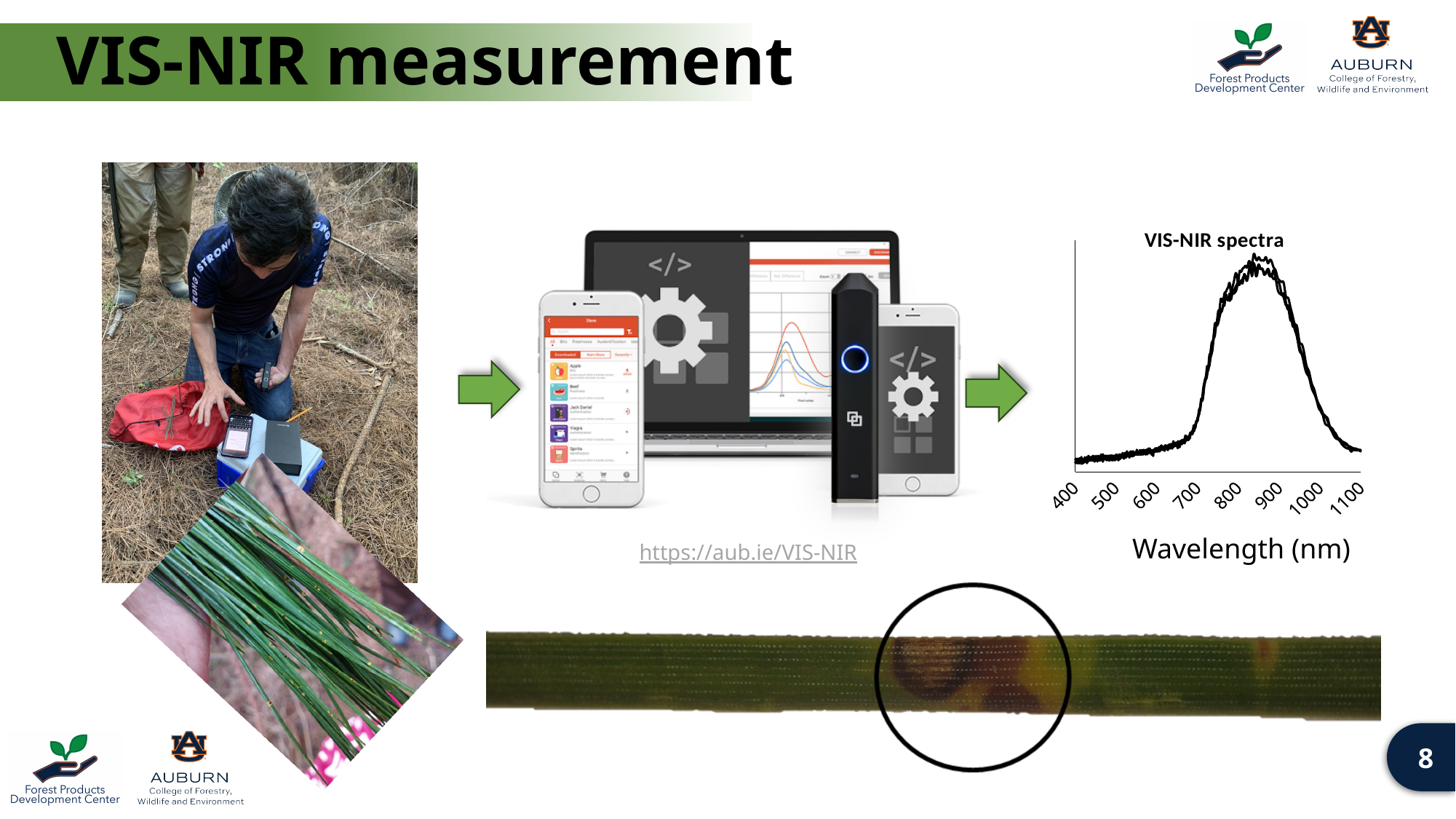
How many tick labels are shown on the x axis of the VIS-NIR spectra chart? 8 What is the spacing between consecutive x-axis ticks on the VIS-NIR spectra chart? 100 What is the title of the chart on the right side of the slide? VIS-NIR spectra In the VIS-NIR spectra chart, is the value at 1100 nm larger or smaller than the value at 900 nm? smaller In the VIS-NIR spectra chart, is the value at 850 nm larger or smaller than the value at 500 nm? larger What is the lowest wavelength tick shown on the x axis of the VIS-NIR spectra chart? 400 In the VIS-NIR spectra chart, do the curves rise or fall between 900 nm and 1100 nm? fall What is the highest wavelength tick shown on the x axis of the VIS-NIR spectra chart? 1100 In the VIS-NIR spectra chart, do the curves rise or fall between 600 nm and 800 nm? rise What kind of chart is the VIS-NIR spectra chart? line chart What is the x-axis label of the VIS-NIR spectra chart? Wavelength (nm)